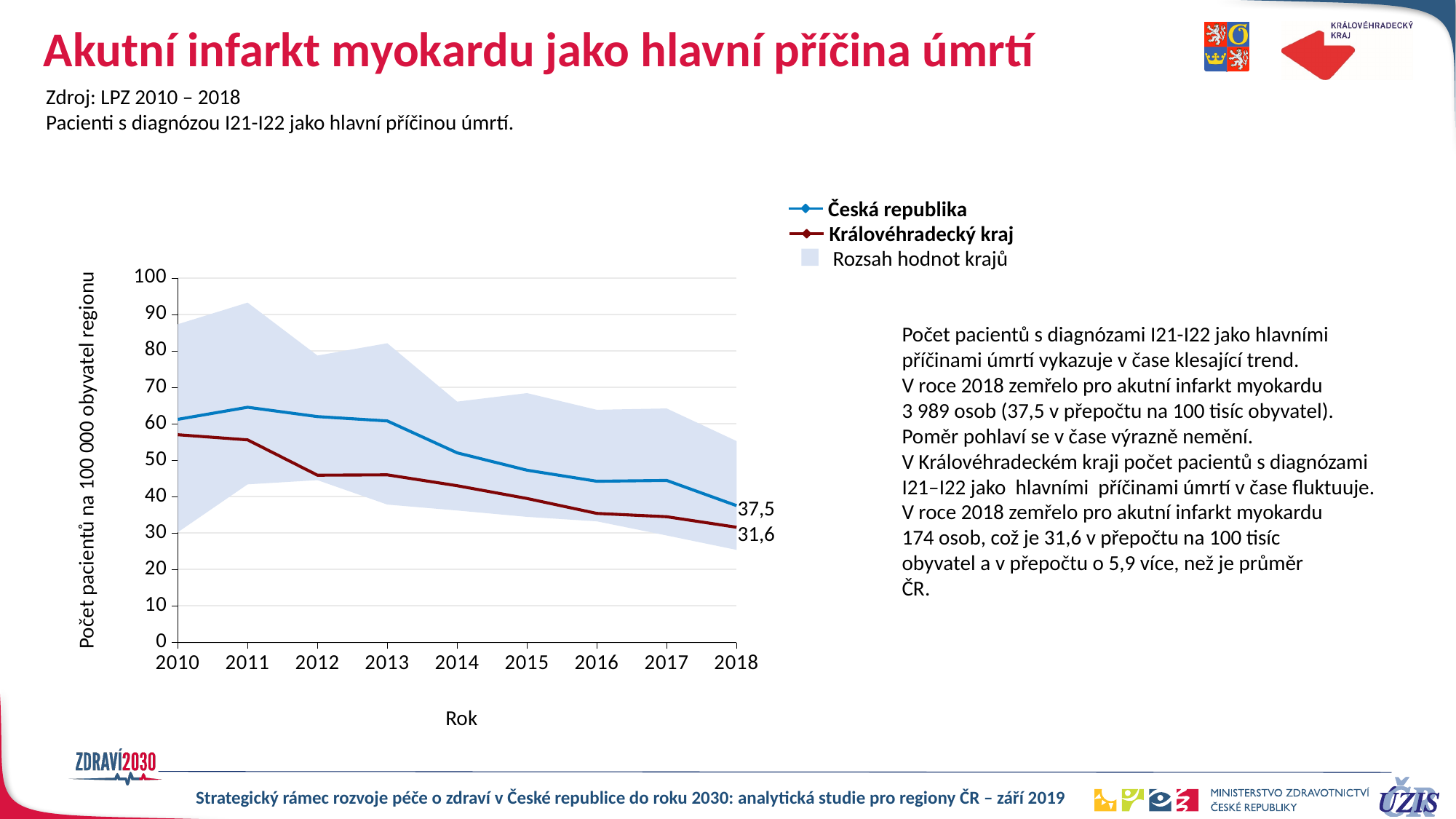
Is the value for Královéhradecký kraj in 2016 greater or less than 40? less What is the value for Královéhradecký kraj in 2018? 31,6 What is the value for Česká republika in 2018? 37,5 Is the value for Královéhradecký kraj in 2012 greater or less than 50? less In 2018, which series has the higher value, Česká republika or Královéhradecký kraj? Česká republika What kind of chart is shown on the slide? line chart How many years are shown on the x axis? 9 What is the difference between the 2018 values for Česká republika and Královéhradecký kraj? 5,9 How many entries does the legend list? 3 In which year is the value for Česká republika lowest? 2018 Is the value for Česká republika in 2010 greater or less than 50? greater Do the values for Česká republika rise or fall from 2011 to 2018? fall